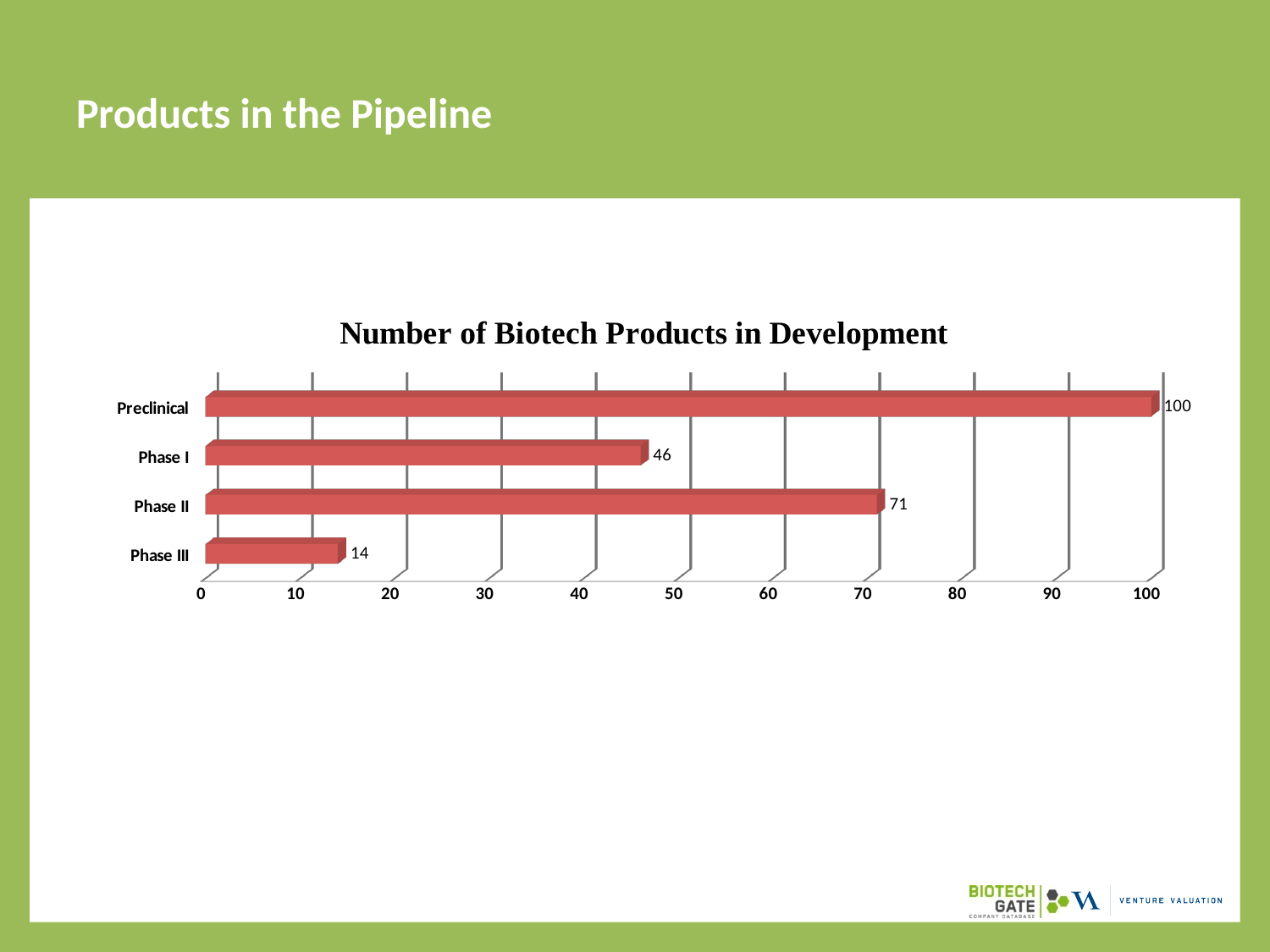
How many stages are shown in the chart? 4 What is the value for Phase I? 46 What is the difference between the Preclinical and Phase III values? 86 What kind of chart is shown on the slide? Bar chart What is the number of biotech products in development at the Preclinical stage? 100 What is the value for Phase II? 71 Which stage has the highest number of products in development? Preclinical What is the value for Phase III? 14 What is the title of the chart? Number of Biotech Products in Development What is the difference between the Phase II and Phase I values? 25 Which is larger, the value for Phase I or the value for Phase II? Phase II Which stage has the lowest number of products in development? Phase III